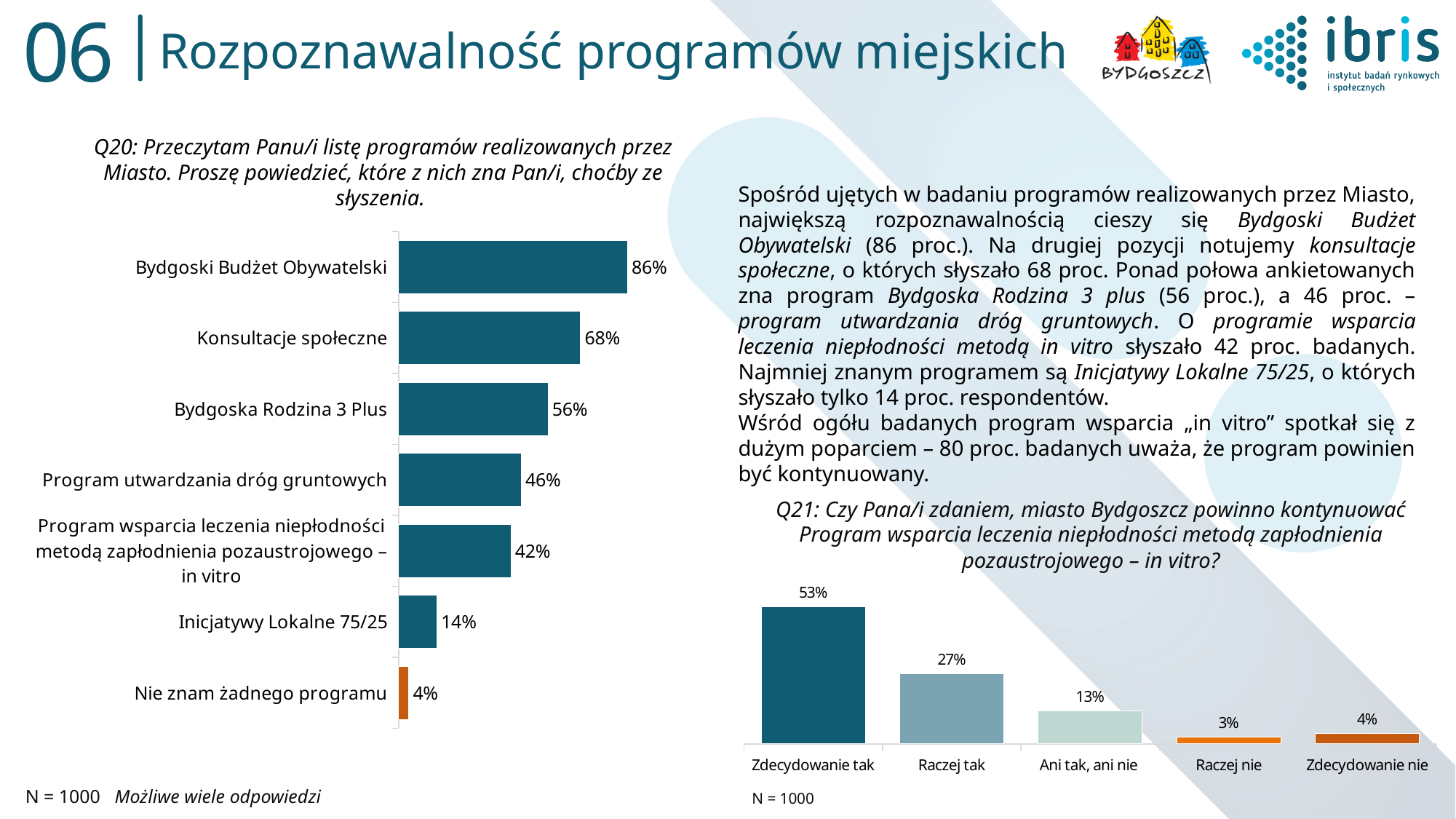
In the Q20 chart on the left, what is the difference between Konsultacje społeczne and Bydgoska Rodzina 3 Plus? 12% In the Q20 chart on the left, which is larger: Program utwardzania dróg gruntowych or Inicjatywy Lokalne 75/25? Program utwardzania dróg gruntowych In the Q20 chart on the left, which bar is coloured orange instead of dark teal? Nie znam żadnego programu What type of chart is the Q20 chart on the left? Bar chart In the Q20 chart on the left, what is the value for Inicjatywy Lokalne 75/25? 14% How many categories are shown in the Q20 chart on the left? 7 In the Q20 chart on the left, which program has the highest recognition? Bydgoski Budżet Obywatelski In the Q21 chart on the right, what is the difference between Zdecydowanie tak and Raczej tak? 26% How many categories are shown in the Q21 chart on the right? 5 In the Q20 chart on the left, what percentage of respondents know Bydgoski Budżet Obywatelski? 86% In the Q21 chart on the right, what is the value for Zdecydowanie tak? 53% In the Q21 chart on the right, which category has the lowest value? Raczej nie